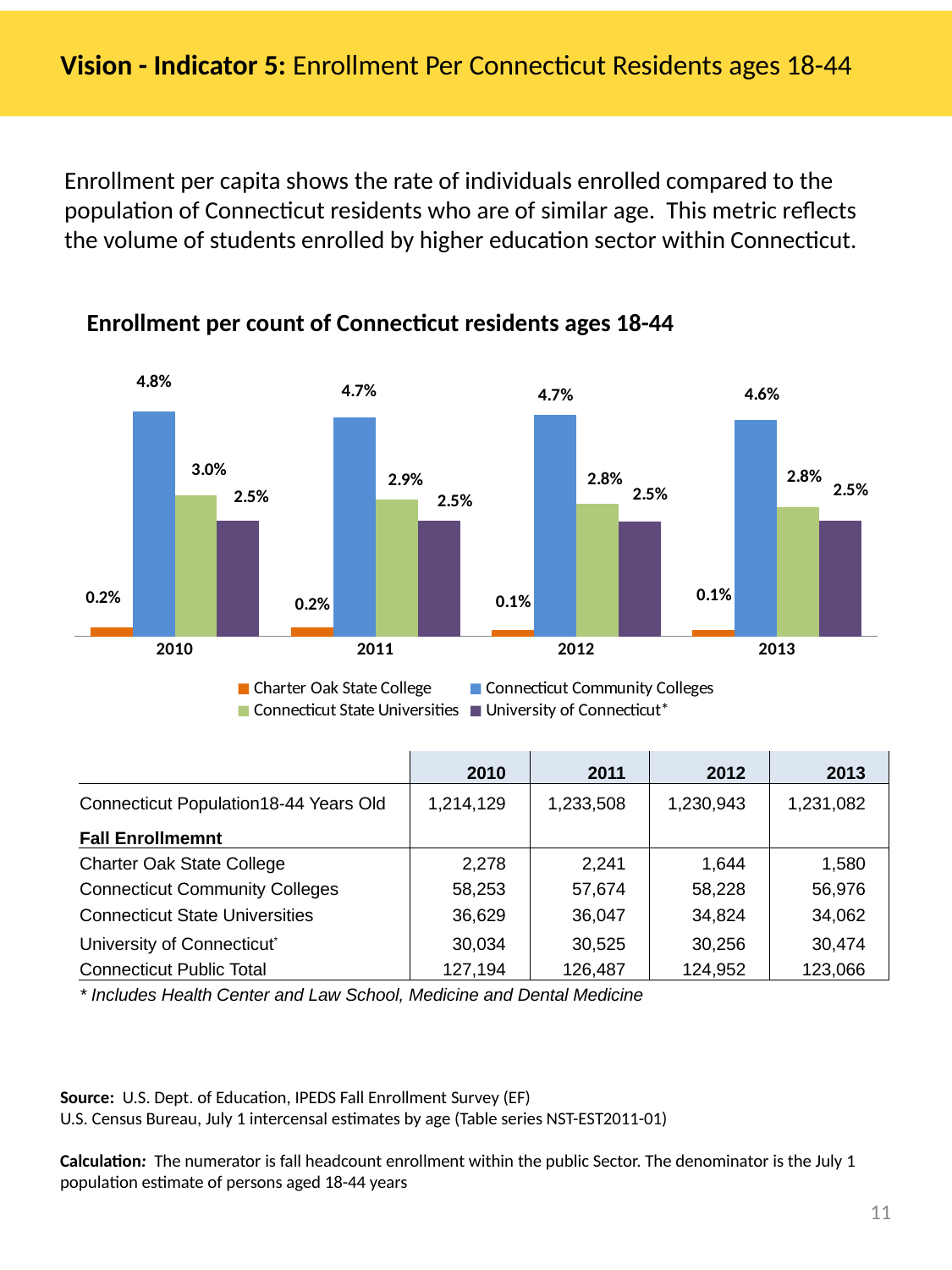
Which series has the highest value in 2013? Connecticut Community Colleges How many years are shown on the x axis of the chart? 4 What is the value for Connecticut Community Colleges in 2010? 4.8% Do the values for Connecticut Community Colleges rise or fall from 2010 to 2013? Fall What is the value for Connecticut State Universities in 2011? 2.9% What is the difference between the Connecticut Community Colleges value and the Connecticut State Universities value in 2010? 1.8% What is the value for Charter Oak State College in 2013? 0.1% Which is larger in 2012: the value for Connecticut State Universities or the value for University of Connecticut? Connecticut State Universities What kind of chart is shown on the slide? Bar chart Which series has the lowest value in 2010? Charter Oak State College What is the value for University of Connecticut in 2012? 2.5% How many series does the chart legend list? 4